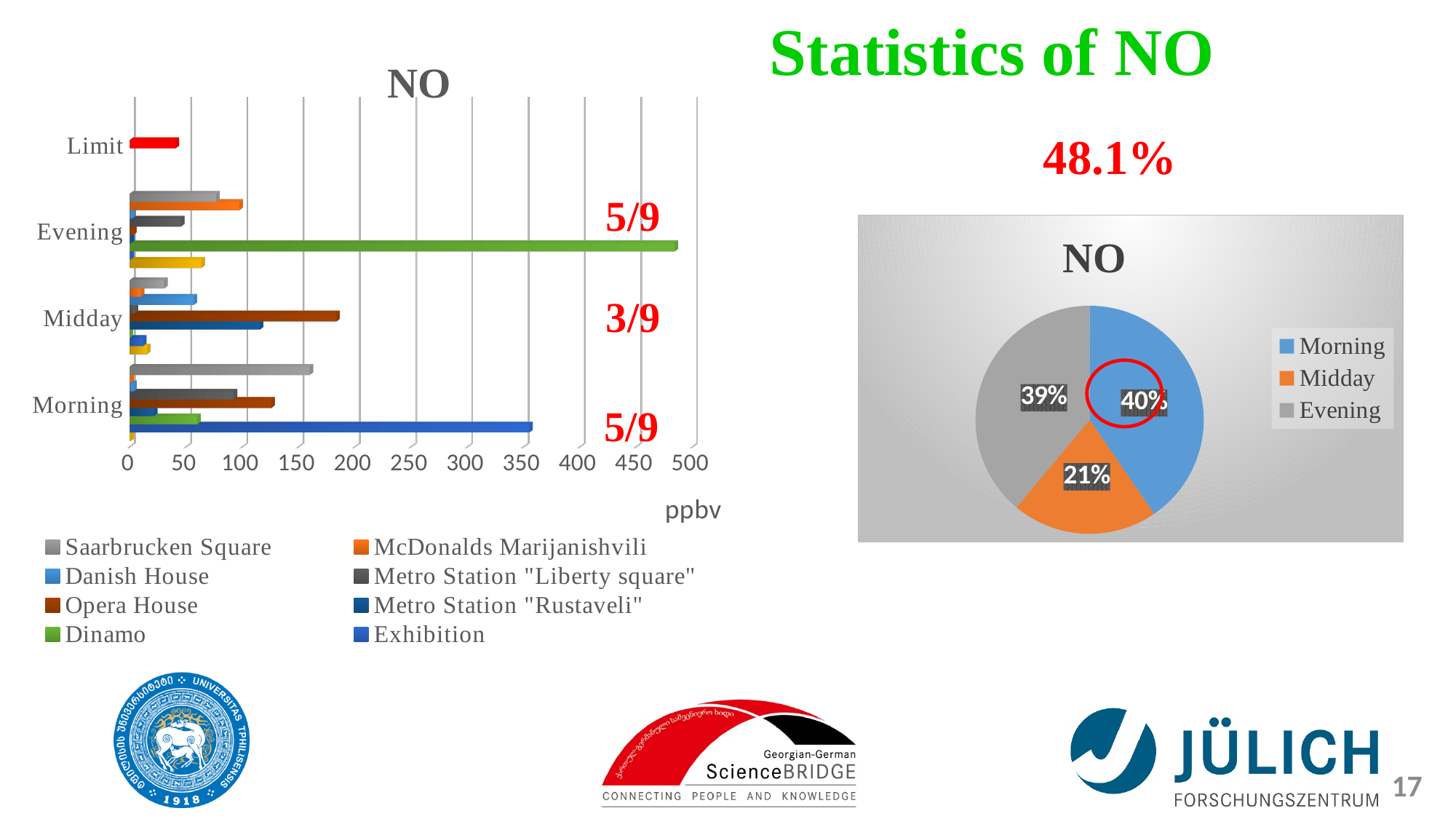
In the right pie chart, what share does Midday have? 21% What kind of chart is the right chart titled NO? pie chart In the left bar chart, is the Evening value for Dinamo greater or less than 450? greater In the left bar chart, what unit is shown on the horizontal axis? ppbv In the left bar chart, how many categories are shown on the vertical axis? 4 In the left bar chart, is the Limit value greater or less than 50? less In the left bar chart, how many series does the legend list? 8 In the left bar chart, is the Morning value for Exhibition greater or less than 300? greater In the right pie chart, what is the difference between the Morning share and the Midday share? 19% In the right pie chart, how many slices are there? 3 What kind of chart is the left chart titled NO? bar chart In the right pie chart, which time of day has the smallest share? Midday